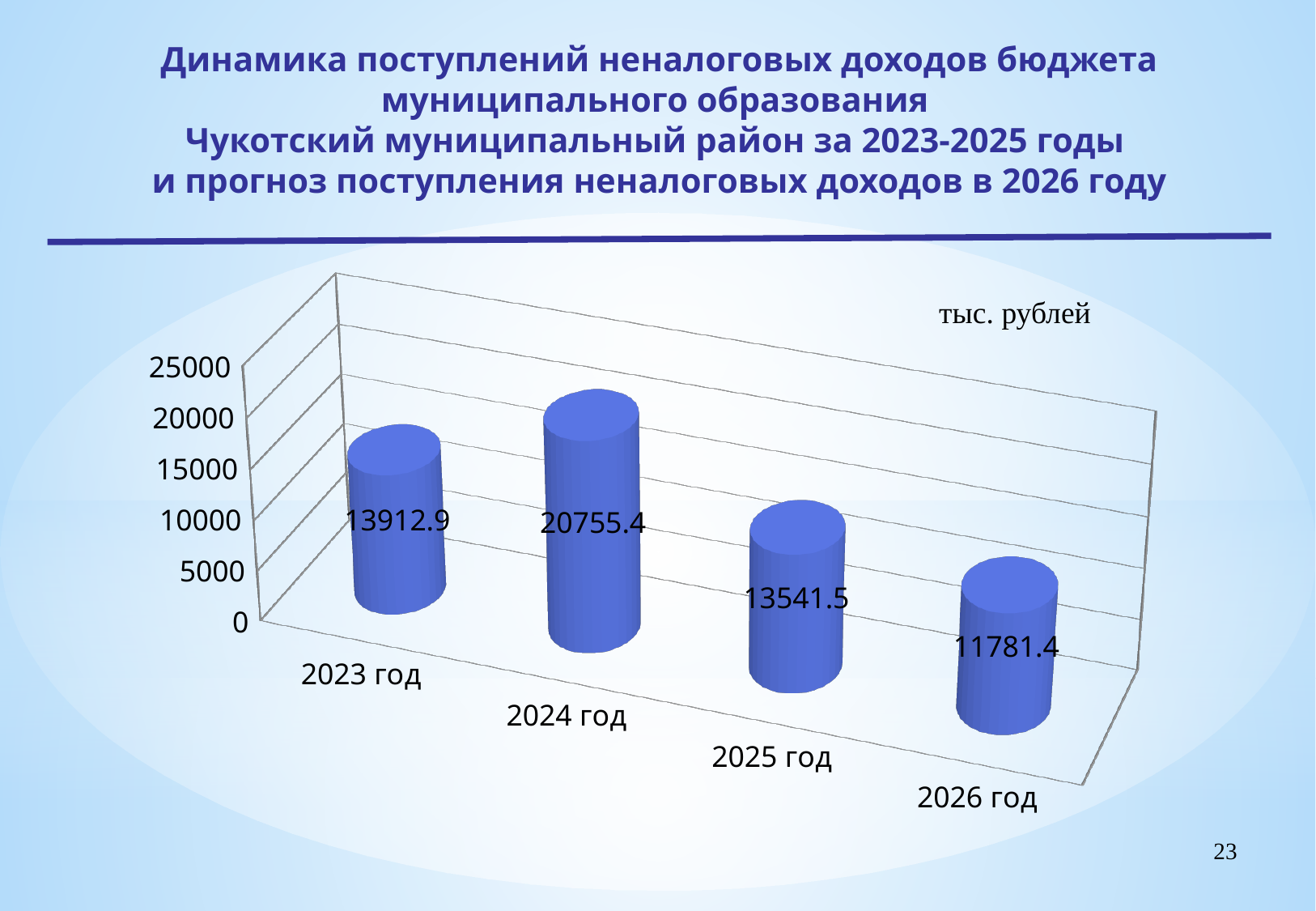
What is the forecast value for 2026 год? 11781.4 Which year has the highest value? 2024 год What is the value for 2023 год? 13912.9 What is the value for 2024 год? 20755.4 Which year has the lowest value? 2026 год What is the value for 2025 год? 13541.5 What is the difference between the values for 2024 год and 2023 год? 6842.5 How many years are shown on the chart? 4 Is the value for 2024 год greater or less than 20000? greater What kind of chart is shown on the slide? bar chart Which is larger, the value for 2024 год or the value for 2026 год? 2024 год What is the difference between the values for 2025 год and 2026 год? 1760.1